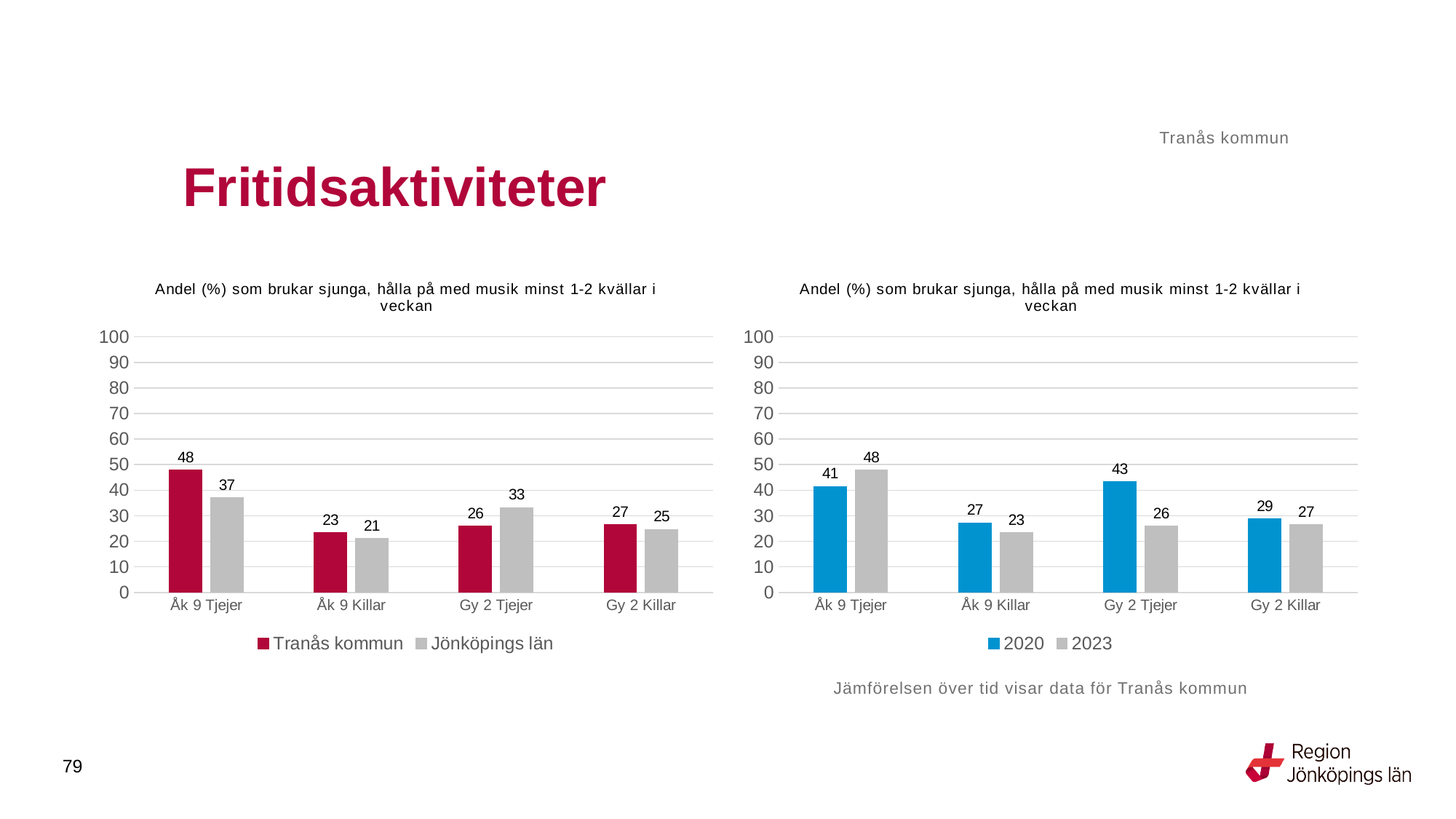
How many categories are shown on the x axis of the right chart? 4 In the left chart, what is the value for Tranås kommun for Åk 9 Tjejer? 48 In the right chart, what is the 2020 value for Gy 2 Tjejer? 43 In the left chart, which category has the highest value for Tranås kommun? Åk 9 Tjejer How many series does the legend of the left chart list? 2 In the left chart, what is the value for Jönköpings län for Gy 2 Tjejer? 33 What kind of chart is the right chart? Bar chart In the left chart, which is larger for Gy 2 Tjejer: Tranås kommun or Jönköpings län? Jönköpings län In the right chart, which category has the lowest 2023 value? Åk 9 Killar In the right chart, what is the difference between the 2020 and 2023 values for Gy 2 Tjejer? 17 In the left chart, what is the difference between Tranås kommun and Jönköpings län for Åk 9 Tjejer? 11 In the right chart, what is the 2023 value for Åk 9 Killar? 23